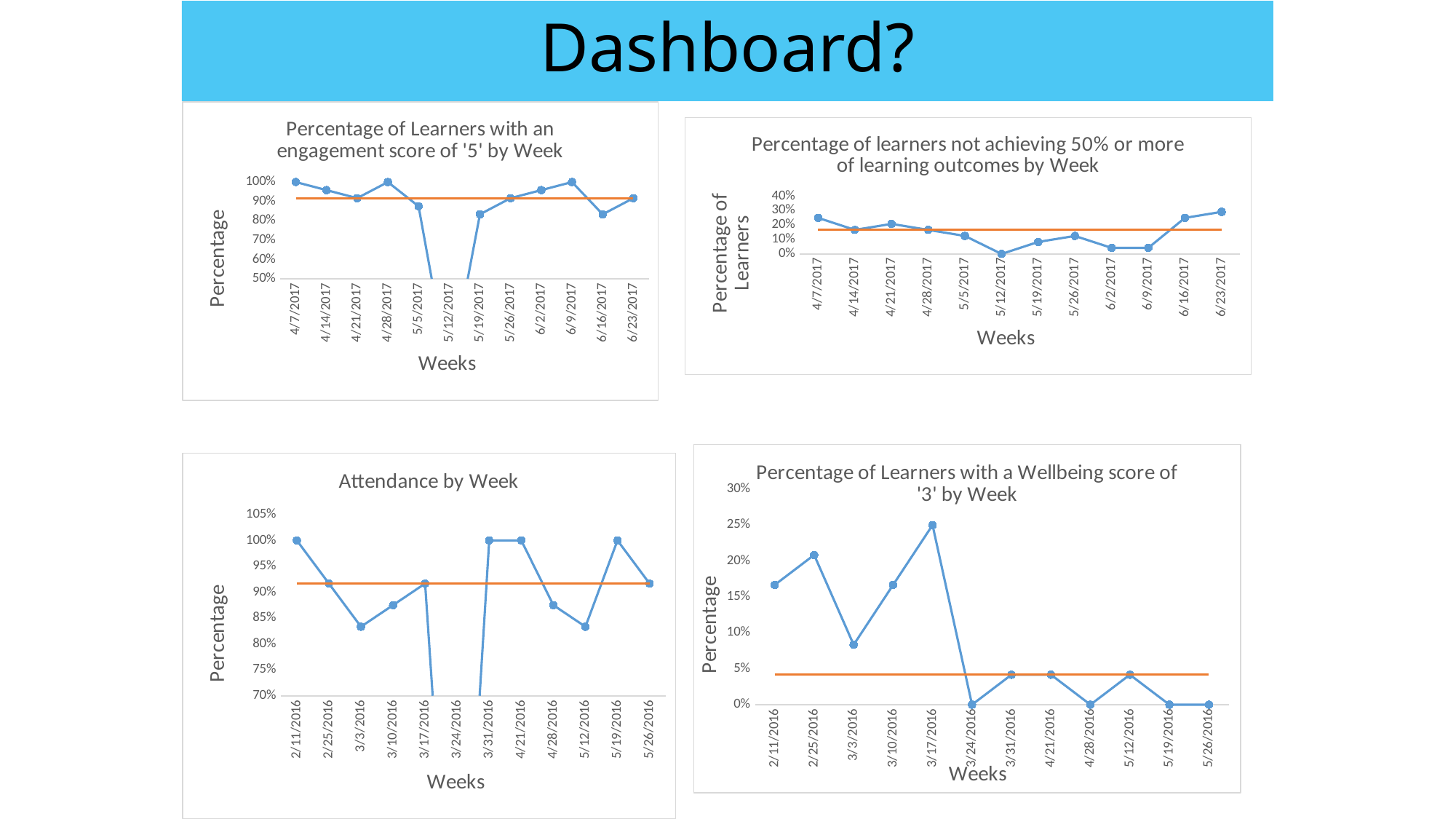
In the 'Percentage of Learners with an engagement score of '5' by Week' chart, what is the value for 4/7/2017? 100% In the 'Percentage of Learners with a Wellbeing score of '3' by Week' chart, which week has the highest value? 3/17/2016 In the 'Attendance by Week' chart, which is larger, the value for 2/11/2016 or the value for 3/3/2016? 2/11/2016 In the 'Percentage of Learners with a Wellbeing score of '3' by Week' chart, is the value for 2/25/2016 greater or less than 15%? greater What kind of chart is the 'Attendance by Week' chart? Line chart In the 'Attendance by Week' chart, is the value for 3/3/2016 greater or less than 90%? less What is the y-axis title of the 'Percentage of learners not achieving 50% or more of learning outcomes by Week' chart? Percentage of Learners In the 'Percentage of learners not achieving 50% or more of learning outcomes by Week' chart, which week has the highest value? 6/23/2017 In the 'Percentage of learners not achieving 50% or more of learning outcomes by Week' chart, which week has the lowest value? 5/12/2017 In the 'Attendance by Week' chart, what is the value for 3/31/2016? 100% In the 'Percentage of Learners with a Wellbeing score of '3' by Week' chart, what is the value for 3/24/2016? 0% How many weeks are plotted on the x axis of the 'Percentage of learners not achieving 50% or more of learning outcomes by Week' chart? 12